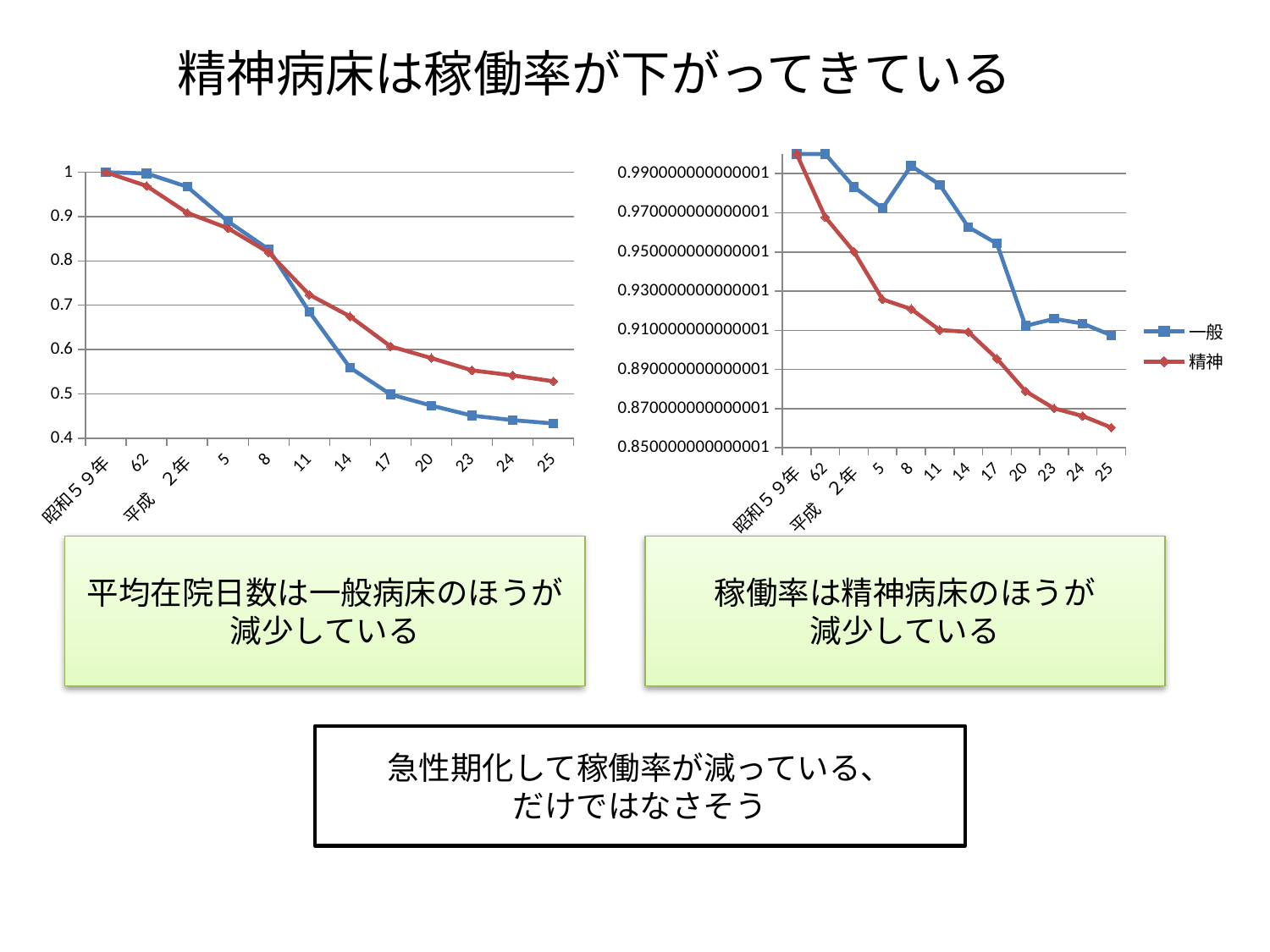
What are the two series named in the legend of the right chart? 一般 and 精神 In the right chart, is the value of 一般 at 平成8 greater or less than 0.97? greater What kind of chart is the chart on the left of the slide? line chart In the left chart, is the value of the red line at 平成14 greater or less than 0.6? greater What kind of chart is the chart on the right of the slide? line chart In the left chart, is the value of the blue line at 平成14 greater or less than 0.6? less How many points along the x axis does the left chart have? 12 How many series does the legend of the right chart list? 2 In the right chart, do the values of the 精神 series rise or fall from 昭和59年 to 平成25? fall In the left chart, at 平成25, which line is higher, the blue line or the red line? the red line In the right chart, at 平成25, which series has the larger value, 一般 or 精神? 一般